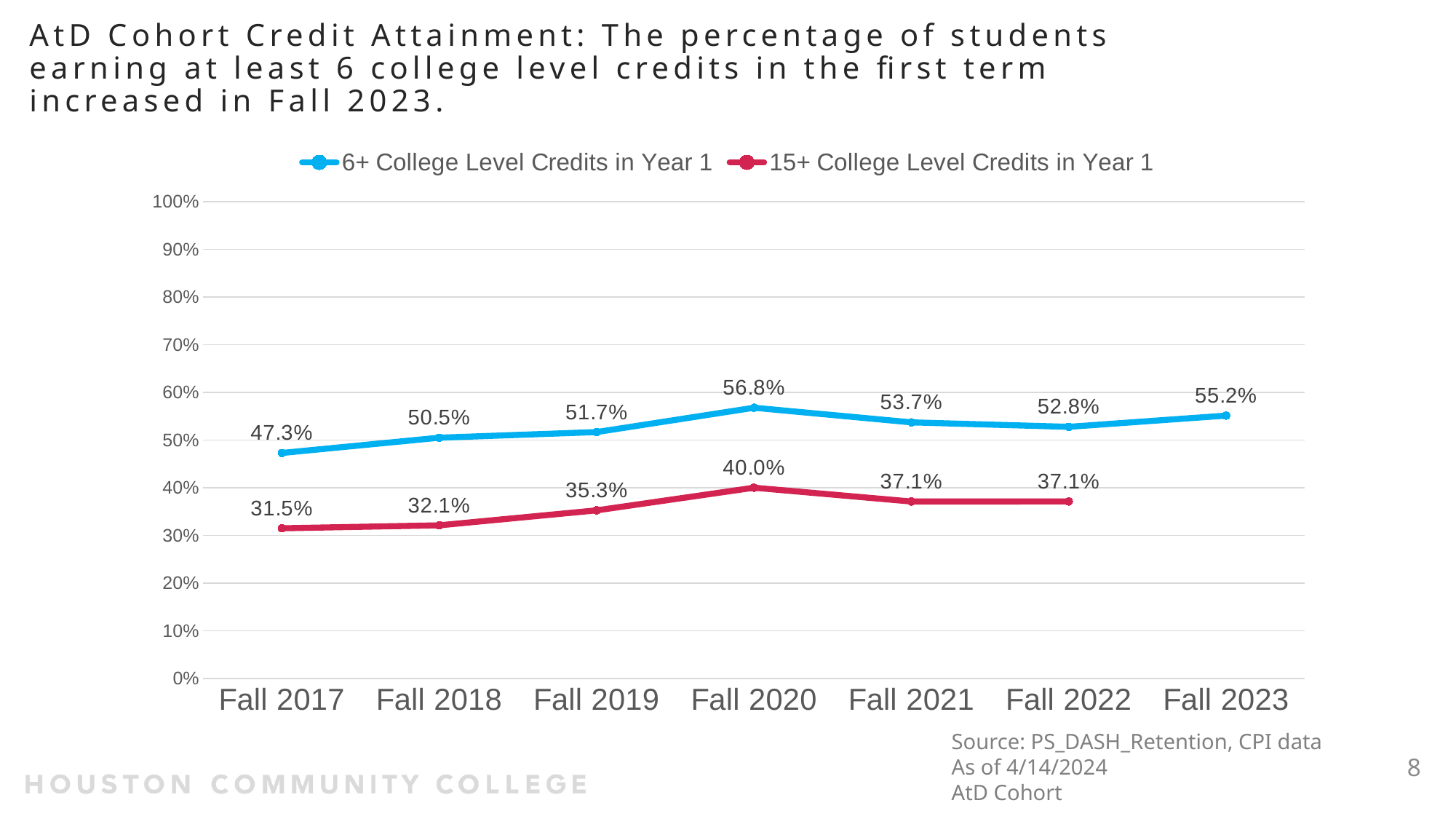
In which cohort is the 6+ College Level Credits in Year 1 value highest? Fall 2020 What kind of chart is shown on the slide? line chart In which cohort is the 15+ College Level Credits in Year 1 value lowest? Fall 2017 Is the value for 15+ College Level Credits in Year 1 in Fall 2020 greater or less than 50%? less What is the value for 15+ College Level Credits in Year 1 in Fall 2019? 35.3% Does the 15+ College Level Credits in Year 1 series rise or fall from Fall 2017 to Fall 2020? rise What is the value for 6+ College Level Credits in Year 1 in Fall 2017? 47.3% What is the value for 6+ College Level Credits in Year 1 in Fall 2023? 55.2% Which is larger for 6+ College Level Credits in Year 1: Fall 2021 or Fall 2022? Fall 2021 How many cohorts are shown on the x axis? 7 How many series does the legend list? 2 What is the difference between the 6+ and 15+ College Level Credits in Year 1 values in Fall 2020? 16.8%